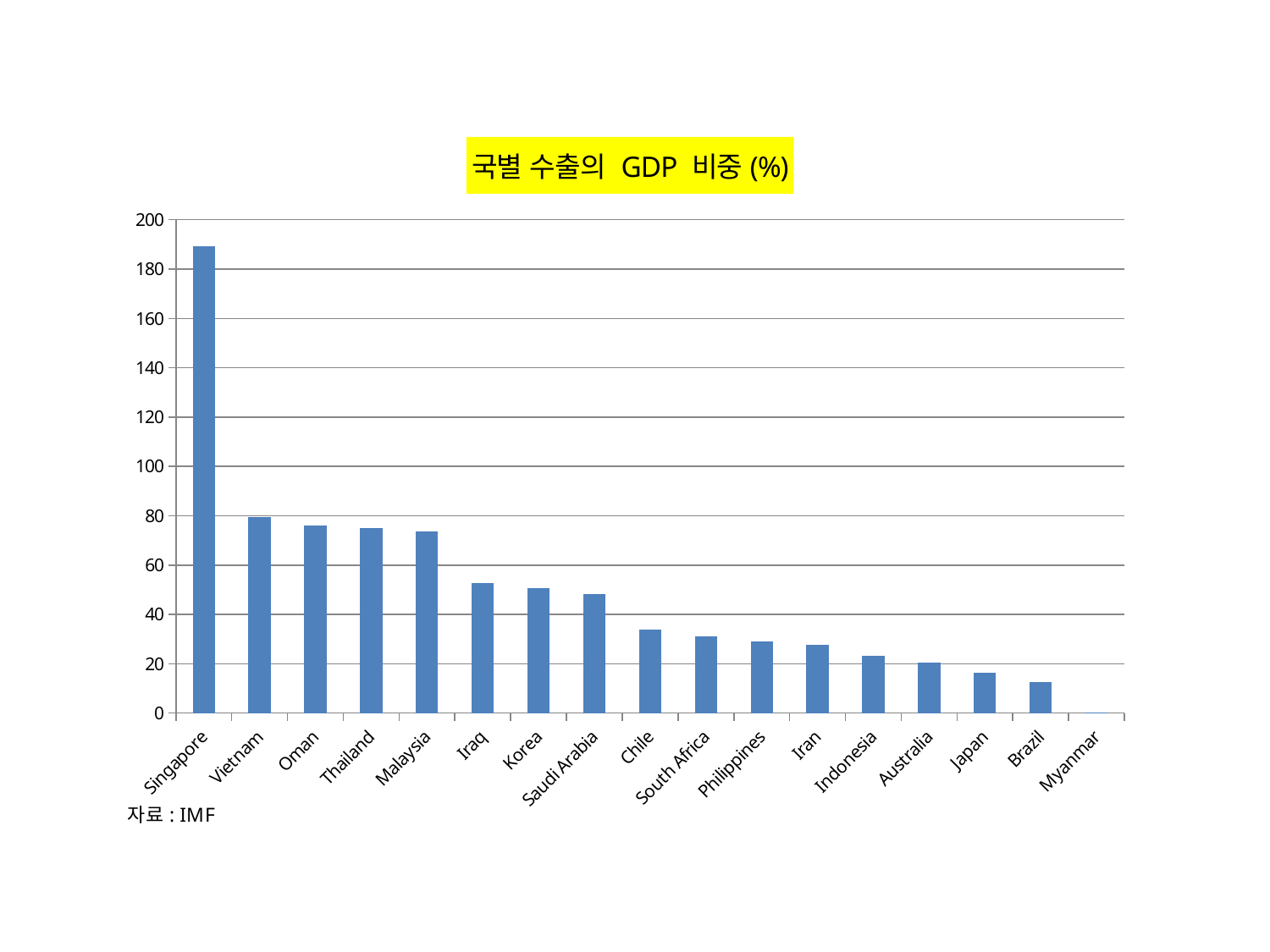
Is the value for Vietnam greater or less than 60? greater Is the value for Singapore greater or less than 180? greater Which has a larger value, Korea or Japan? Korea What kind of chart is shown on the slide? bar chart Which country has the lowest export share of GDP in the chart? Myanmar How many countries are shown on the x axis of the chart? 17 Is the value for Chile greater or less than 40? less What source is cited below the chart? IMF Do the values generally rise or fall moving from left to right along the x axis? fall Which country has the highest export share of GDP in the chart? Singapore